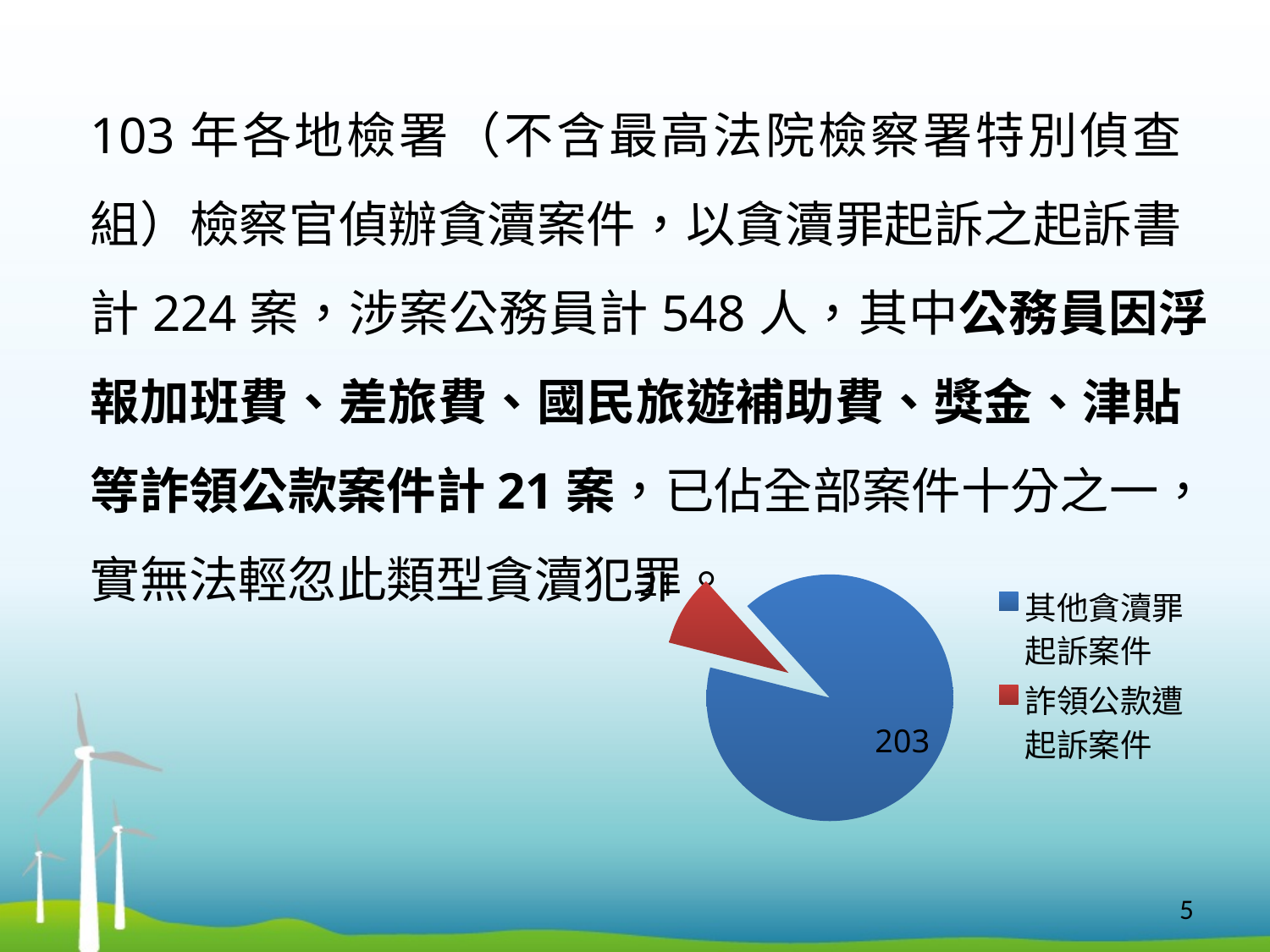
What value is labelled on the 其他貪瀆罪起訴案件 slice of the pie chart? 203 Which category has the smallest slice in the pie chart? 詐領公款遭起訴案件 How many entries does the legend of the pie chart list? 2 What kind of chart is shown on the slide? pie chart Which category has the largest slice in the pie chart? 其他貪瀆罪起訴案件 Which slice of the pie chart is pulled out (exploded) from the rest of the pie? 詐領公款遭起訴案件 Which slice is larger in the pie chart, 其他貪瀆罪起訴案件 or 詐領公款遭起訴案件? 其他貪瀆罪起訴案件 What colour is the 詐領公款遭起訴案件 slice in the pie chart? red How many slices does the pie chart have? 2